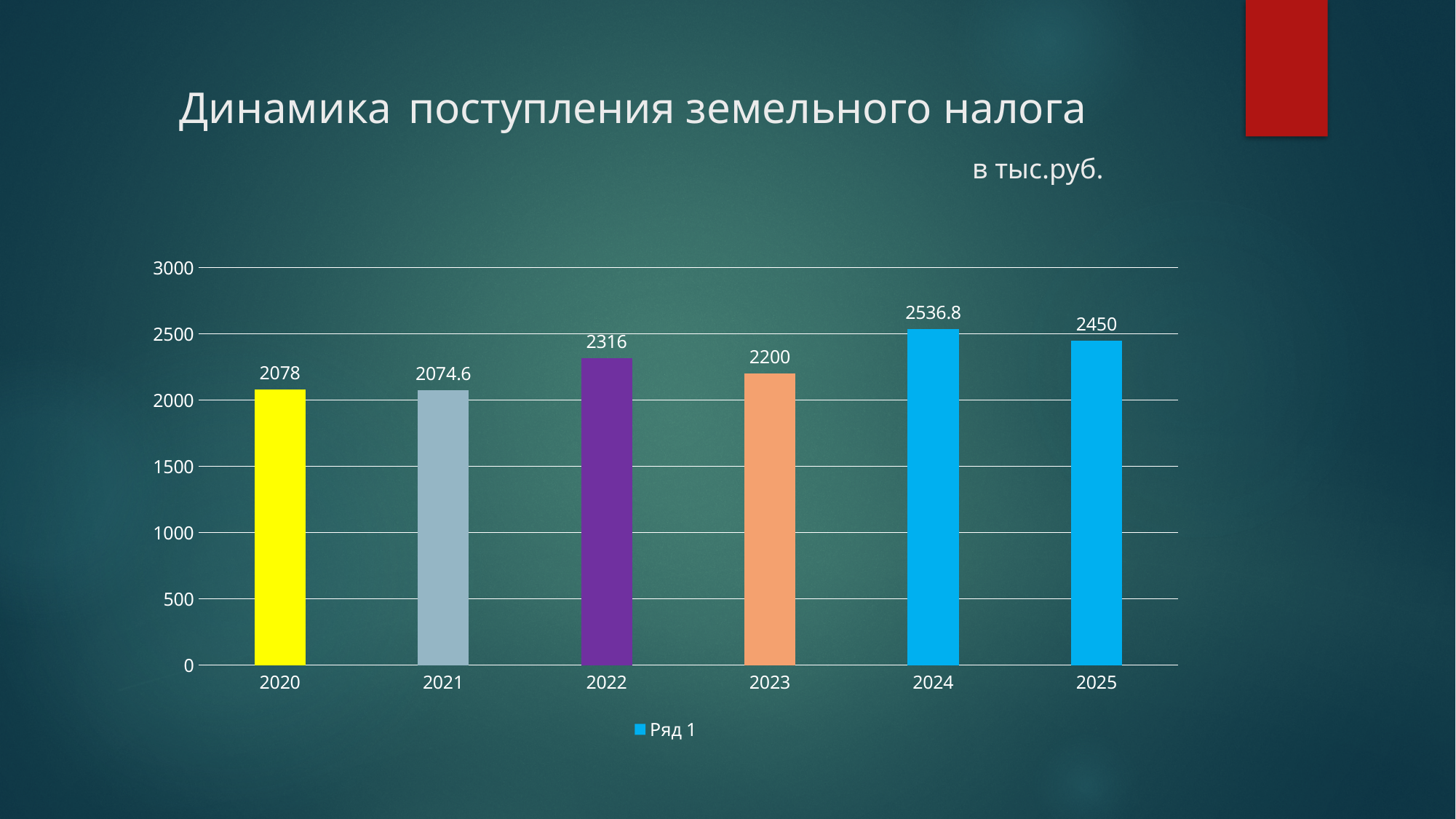
What is the difference between the values for 2022 and 2023? 116 What is the title of the chart? Динамика поступления земельного налога How many years are shown on the x axis? 6 What kind of chart is shown on the slide? bar chart What is the value for 2020? 2078 What is the value for 2021? 2074.6 What is the value for 2024? 2536.8 Which year has the lowest value? 2021 Which is larger, the value for 2022 or the value for 2023? 2022 Is the value for 2024 greater or less than 2500? greater What is the difference between the values for 2024 and 2025? 86.8 Which year has the highest value? 2024